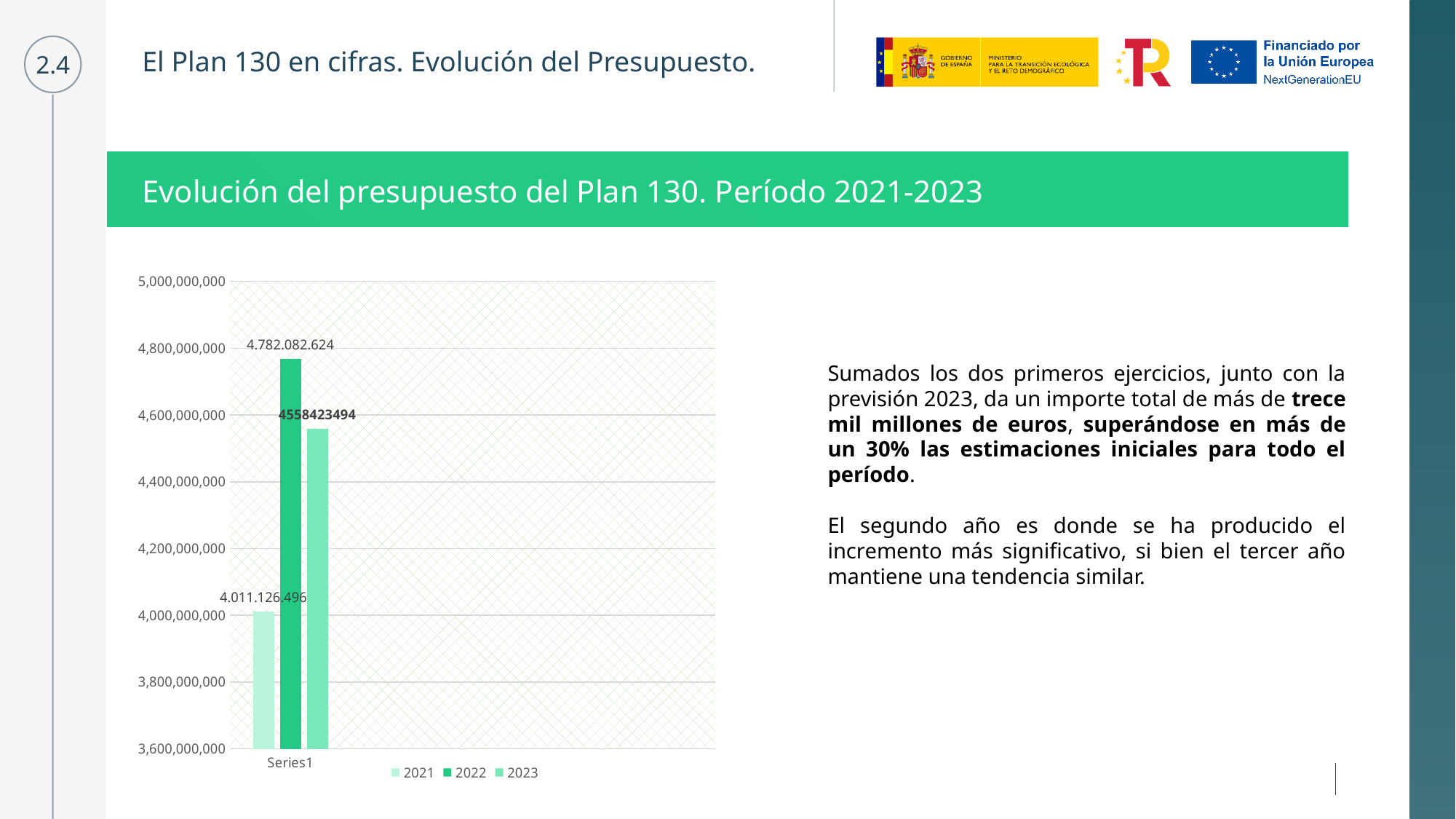
What is the value of the 2022 bar in the chart? 4.782.082.624 What kind of chart is shown on the slide? bar chart What is the value of the 2023 bar in the chart? 4558423494 Which year has the lowest bar in the chart? 2021 How many series does the legend list? 3 Which year has the highest bar in the chart? 2022 What is the difference between the 2022 and 2023 values in the chart? 223.659.130 Which is larger in the chart, the 2023 value or the 2021 value? 2023 What is the category label shown on the x axis of the chart? Series1 What is the difference between the 2022 and 2021 values in the chart? 770.956.128 What is the value of the 2021 bar in the chart? 4.011.126.496 Is the value for 2023 greater or less than 4,400,000,000? greater